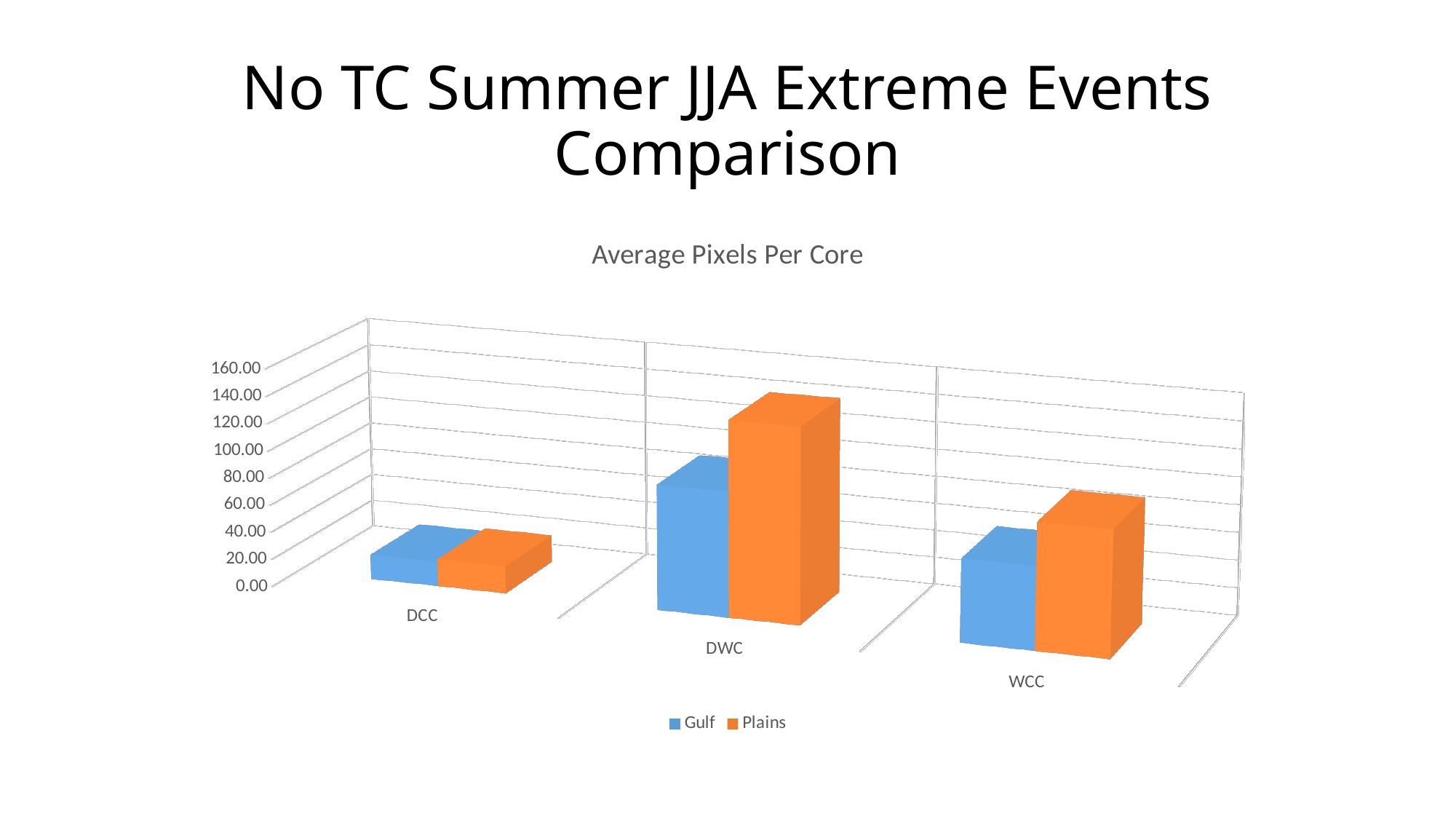
Which category has the highest Gulf value? DWC For DWC, which is larger, the Gulf value or the Plains value? Plains Is the Plains value for DWC greater or less than 100? greater For WCC, which is larger, the Gulf value or the Plains value? Plains Which category has the highest Plains value? DWC What is the title of the chart? Average Pixels Per Core How many categories are shown on the x axis? 3 Which series is shown in orange? Plains Is the Gulf value for DCC greater or less than 60? less Which category has the lowest Plains value? DCC How many series does the legend list? 2 What kind of chart is shown on the slide? bar chart